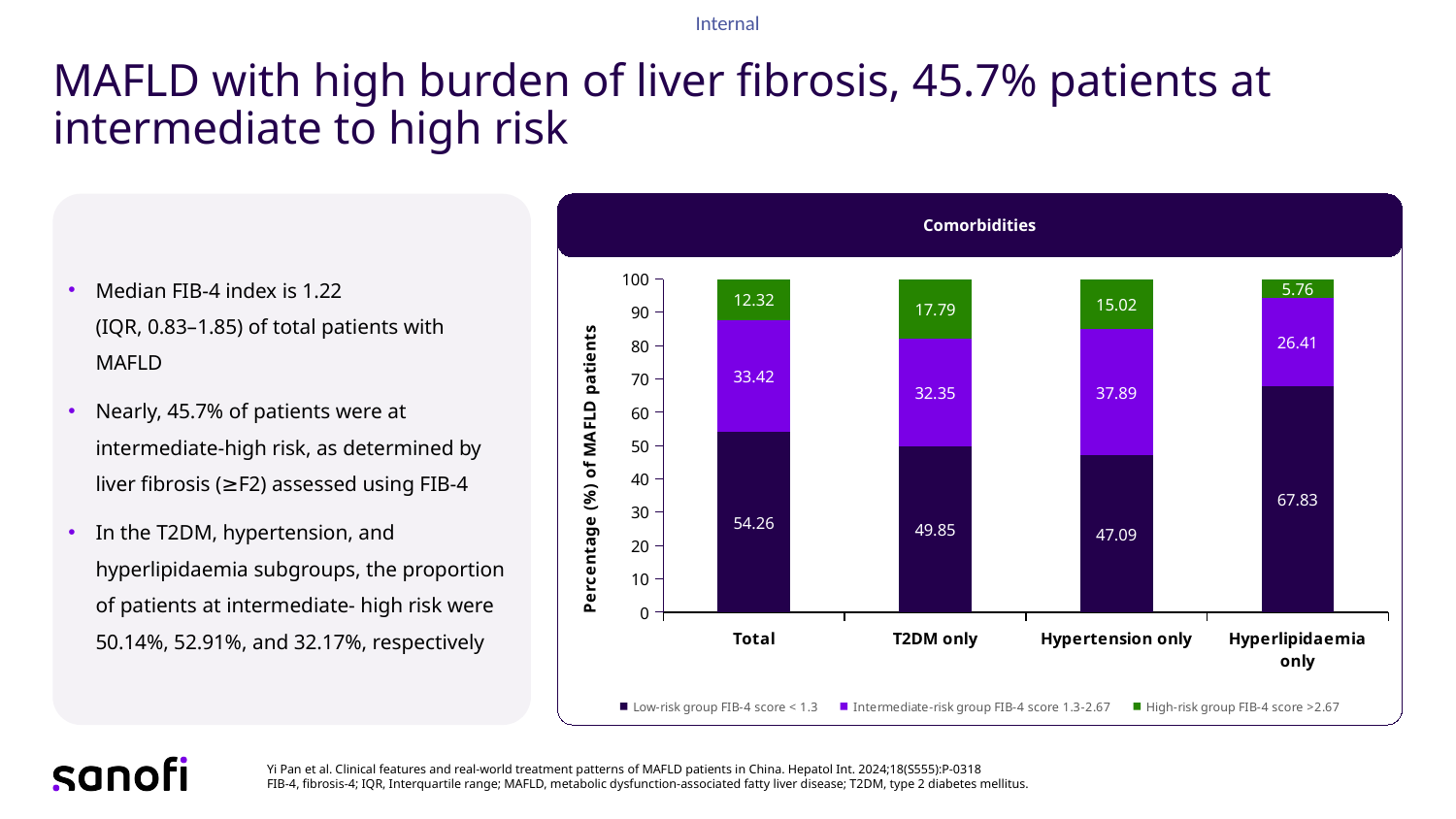
How many series does the legend list? 3 What is the intermediate-risk group value for Hypertension only? 37.89 How many categories are shown on the x axis? 4 What is the total of the stacked bar for Hypertension only? 100.00 Which category has the lowest high-risk group value? Hyperlipidaemia only What is the high-risk group value for T2DM only? 17.79 What is the difference between the low-risk group values for Total and T2DM only? 4.41 What kind of chart is shown? Stacked bar chart Which category has the highest low-risk group value? Hyperlipidaemia only What is the title of the chart? Comorbidities Which is larger, the intermediate-risk group value for Hypertension only or for T2DM only? Hypertension only What is the low-risk group value for Hyperlipidaemia only? 67.83